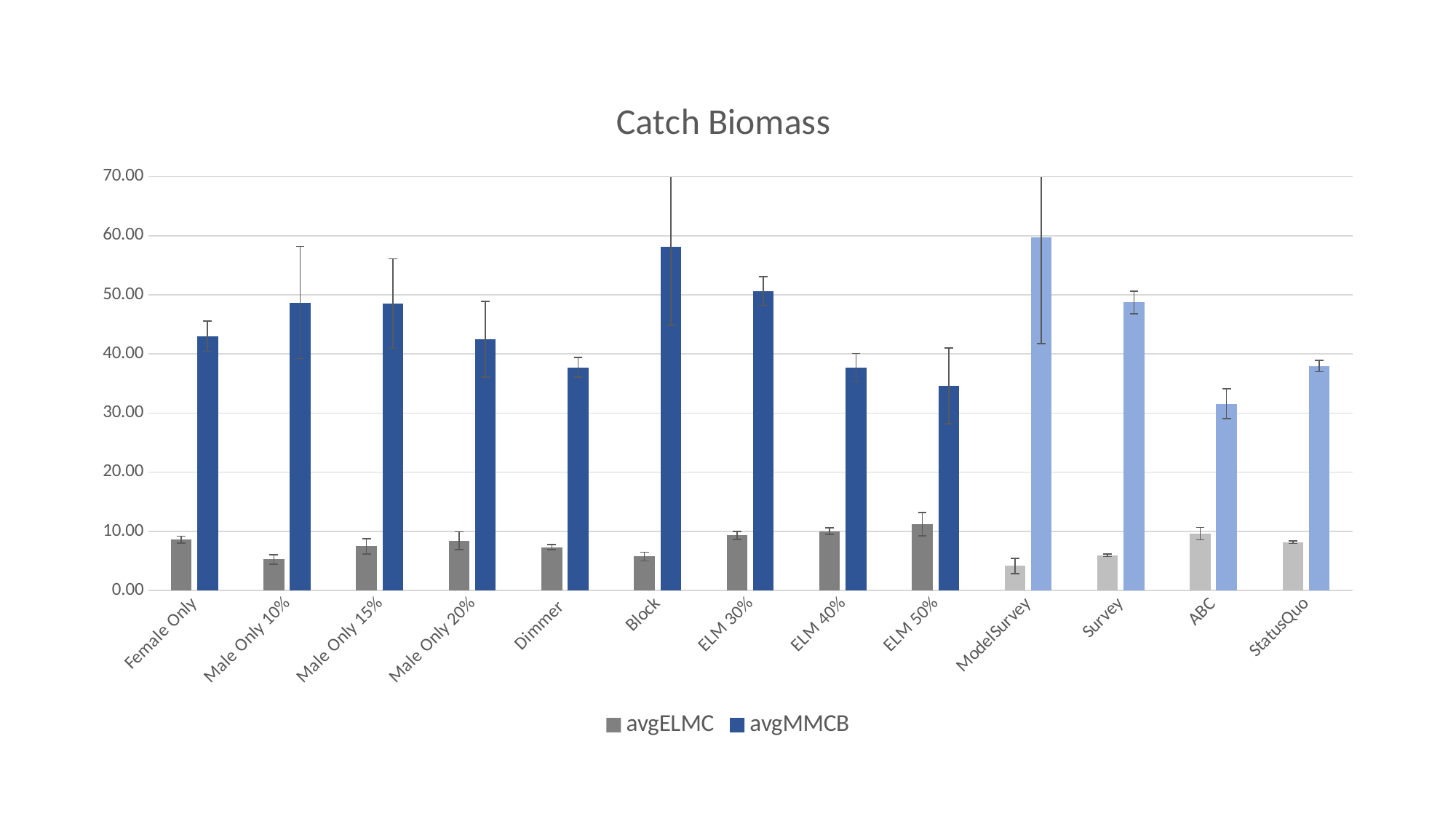
Is the avgMMCB value for Block greater or less than 50.00? greater Is the avgMMCB value for ELM 40% greater or less than 40.00? less Which has the larger avgELMC value, Female Only or Male Only 10%? Female Only How many series does the legend list? 2 What kind of chart is shown on the slide? bar chart Is the avgELMC value for ModelSurvey greater or less than 10.00? less What is the title of the chart? Catch Biomass Which has the larger avgMMCB value, Block or Dimmer? Block Which category has the lowest avgELMC value? ModelSurvey How many categories are shown on the x axis? 13 Which category has the lowest avgMMCB value? ABC